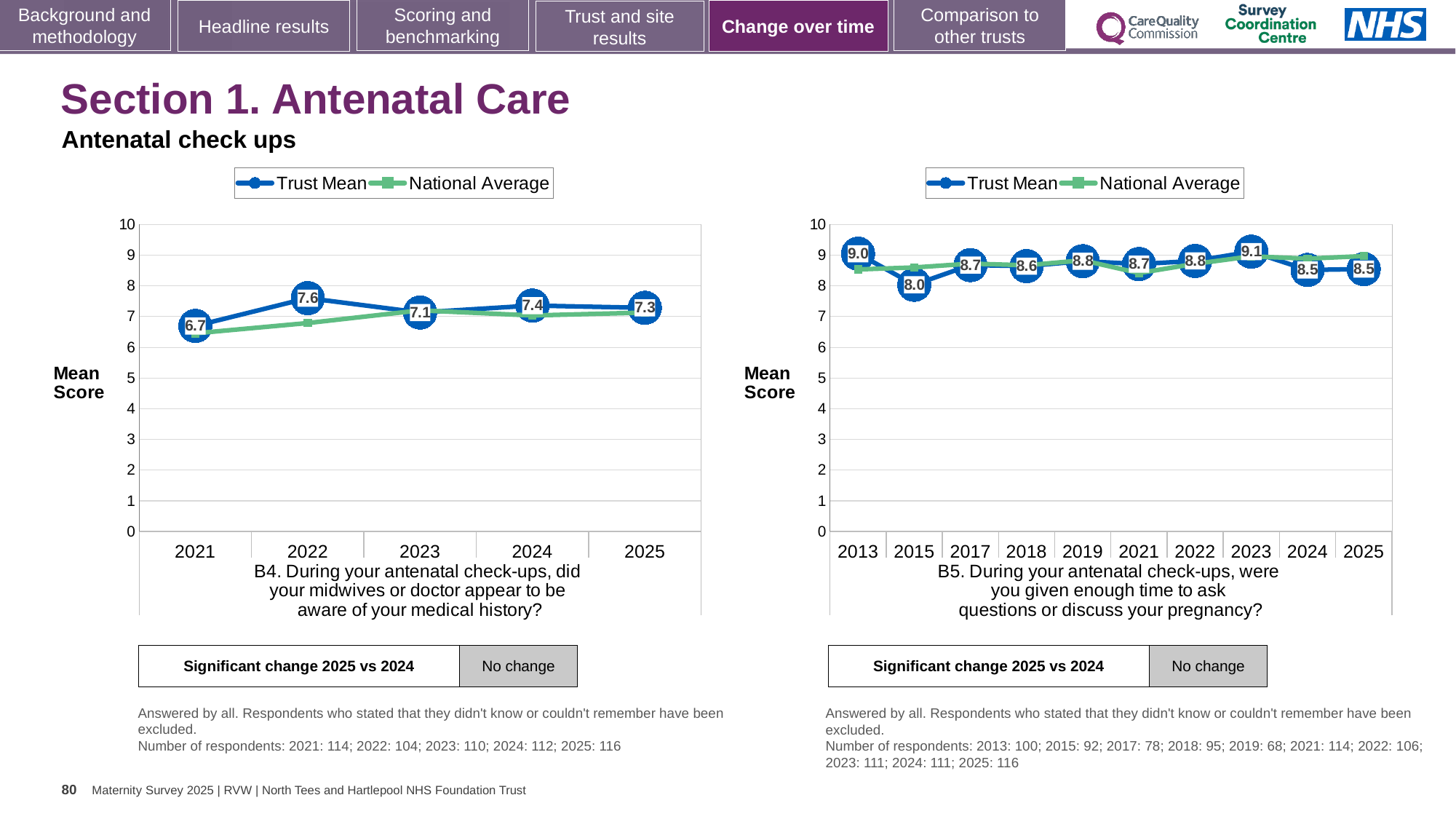
What kind of chart is the B5 chart (right)? Line chart How many series does the legend of the B4 chart (left) list? 2 In the B4 chart (left), how many years are shown on the x axis? 5 In the B4 chart (left), what is the difference between the Trust Mean scores for 2022 and 2021? 0.9 In the B5 chart (right), is the Trust Mean score for 2023 larger than the Trust Mean score for 2024? Yes In the B5 chart (right), what is the Trust Mean score for 2015? 8.0 In the B4 chart (left), which year has the lowest Trust Mean score? 2021 In the B4 chart (left), what is the Trust Mean score for 2025? 7.3 In the B5 chart (right), which year has the lowest Trust Mean score? 2015 In the B5 chart (right), how many years are shown on the x axis? 10 In the B5 chart (right), which year has the highest Trust Mean score? 2023 In the B4 chart (left), what is the Trust Mean score for 2022? 7.6